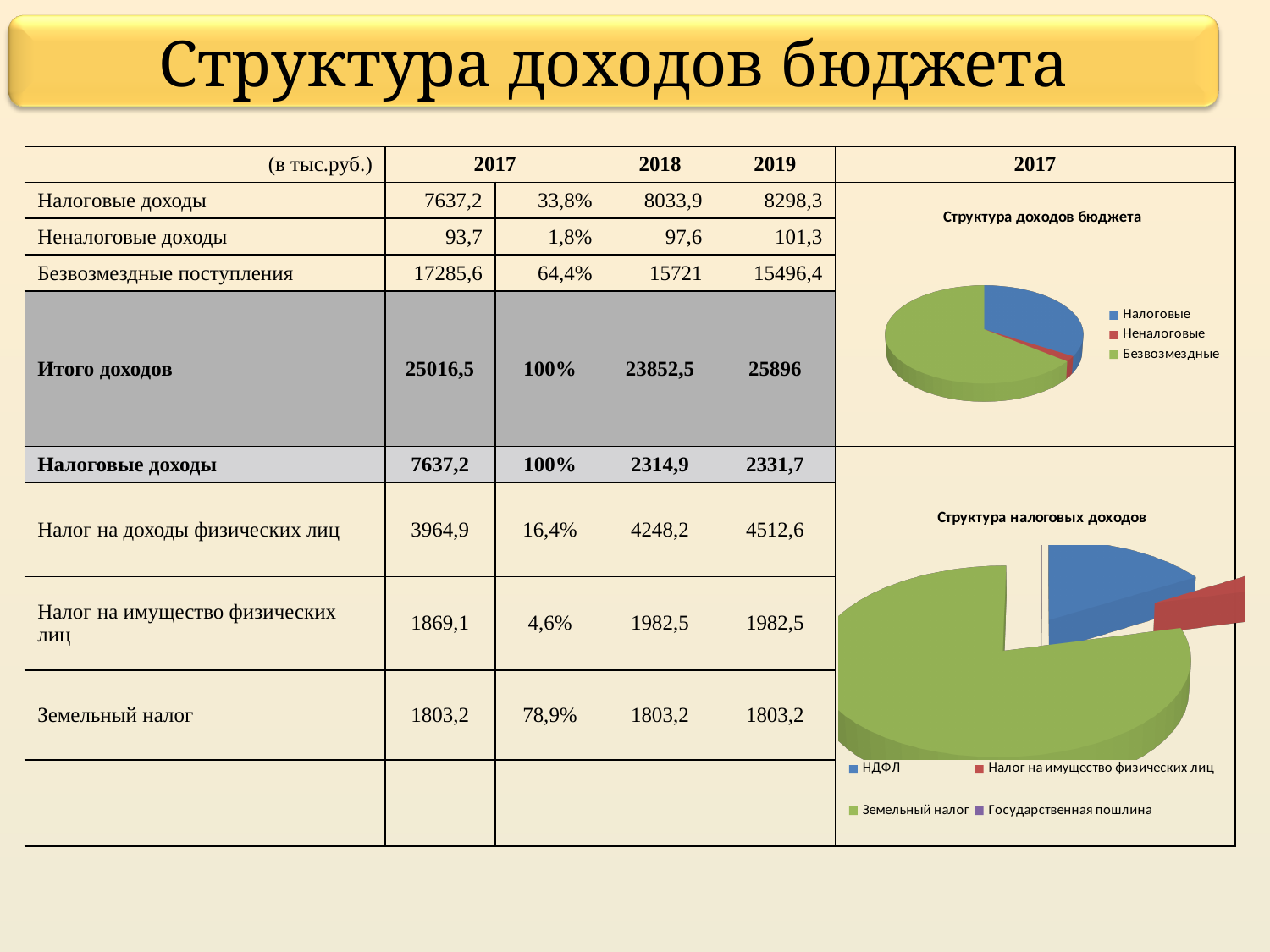
In the 'Структура налоговых доходов' chart, which category has the largest slice? Земельный налог What kind of chart is the 'Структура налоговых доходов' chart? pie chart What kind of chart is the 'Структура доходов бюджета' chart? pie chart In the 'Структура доходов бюджета' chart, how many categories does the legend list? 3 In the 'Структура доходов бюджета' chart, which category has the largest slice? Безвозмездные In the 'Структура доходов бюджета' chart, which slice is larger: Налоговые or Неналоговые? Налоговые In the 'Структура налоговых доходов' chart, which slice is larger: НДФЛ or Налог на имущество физических лиц? НДФЛ In the 'Структура доходов бюджета' chart, which category has the smallest slice? Неналоговые In the 'Структура доходов бюджета' chart, what colour is the Безвозмездные slice? green In the 'Структура налоговых доходов' chart, which category has the smallest slice? Государственная пошлина In the 'Структура налоговых доходов' chart, how many categories does the legend list? 4 What is the title of the lower pie chart on the slide? Структура налоговых доходов